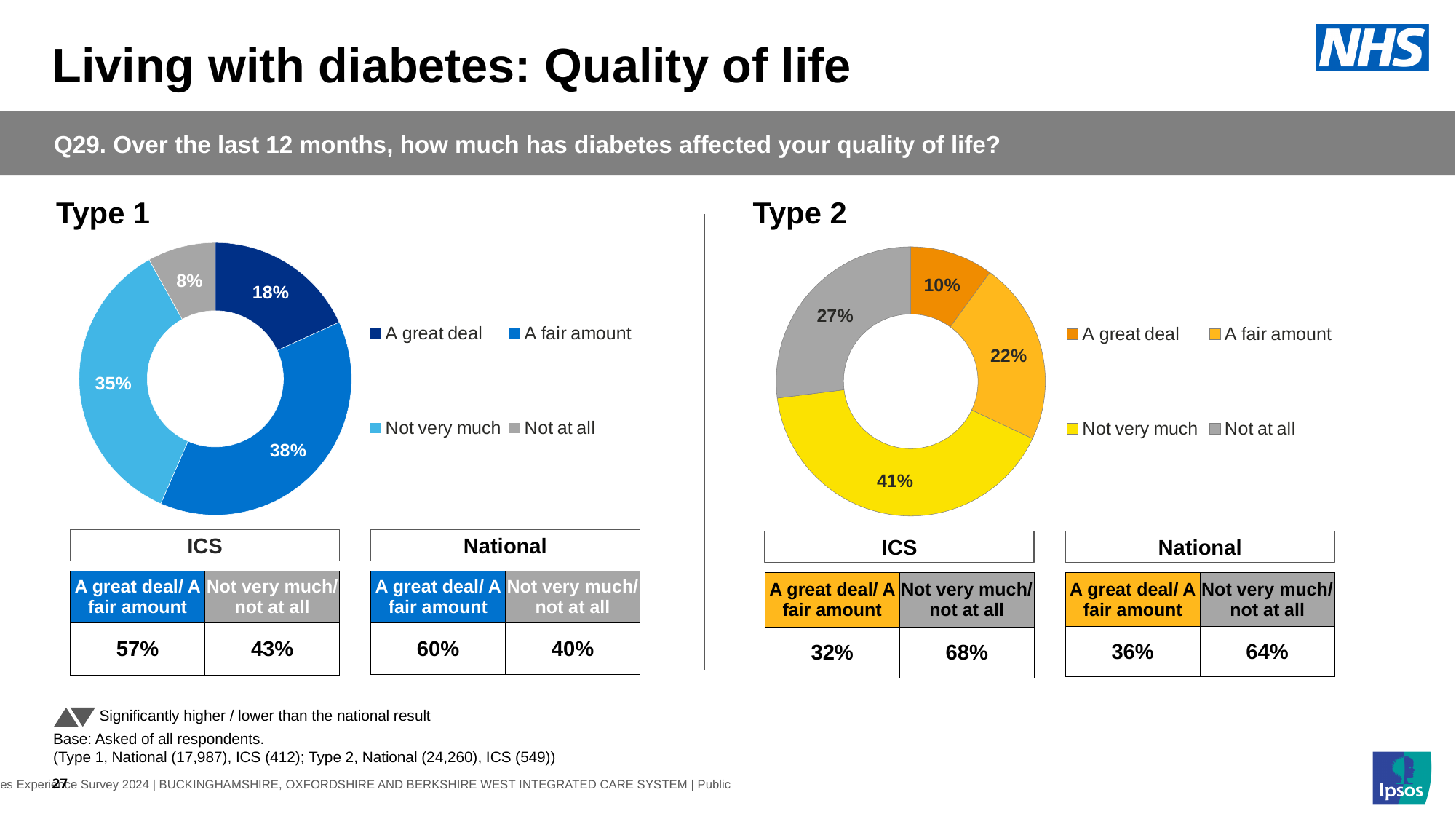
In the Type 2 chart, what percentage of respondents answered 'Not very much'? 41% In the Type 2 chart, what percentage of respondents answered 'A fair amount'? 22% In the Type 2 chart, what colour represents 'Not very much'? Yellow In the Type 2 chart, what is the difference in percentage points between 'Not very much' and 'Not at all'? 14 In the Type 2 chart, which response category has the smallest share? A great deal In the Type 1 chart, what percentage of respondents answered 'Not at all'? 8% How many response categories are shown in the Type 1 chart? 4 In the Type 2 chart, which is larger: the share for 'Not at all' or the share for 'A fair amount'? Not at all In the Type 1 chart, which response category has the largest share? A fair amount In the Type 1 chart, what percentage of respondents said diabetes affected their quality of life 'A great deal'? 18% What kind of chart is used to show the Type 2 results? Donut (pie) chart In the Type 1 chart, what is the difference in percentage points between 'A fair amount' and 'A great deal'? 20